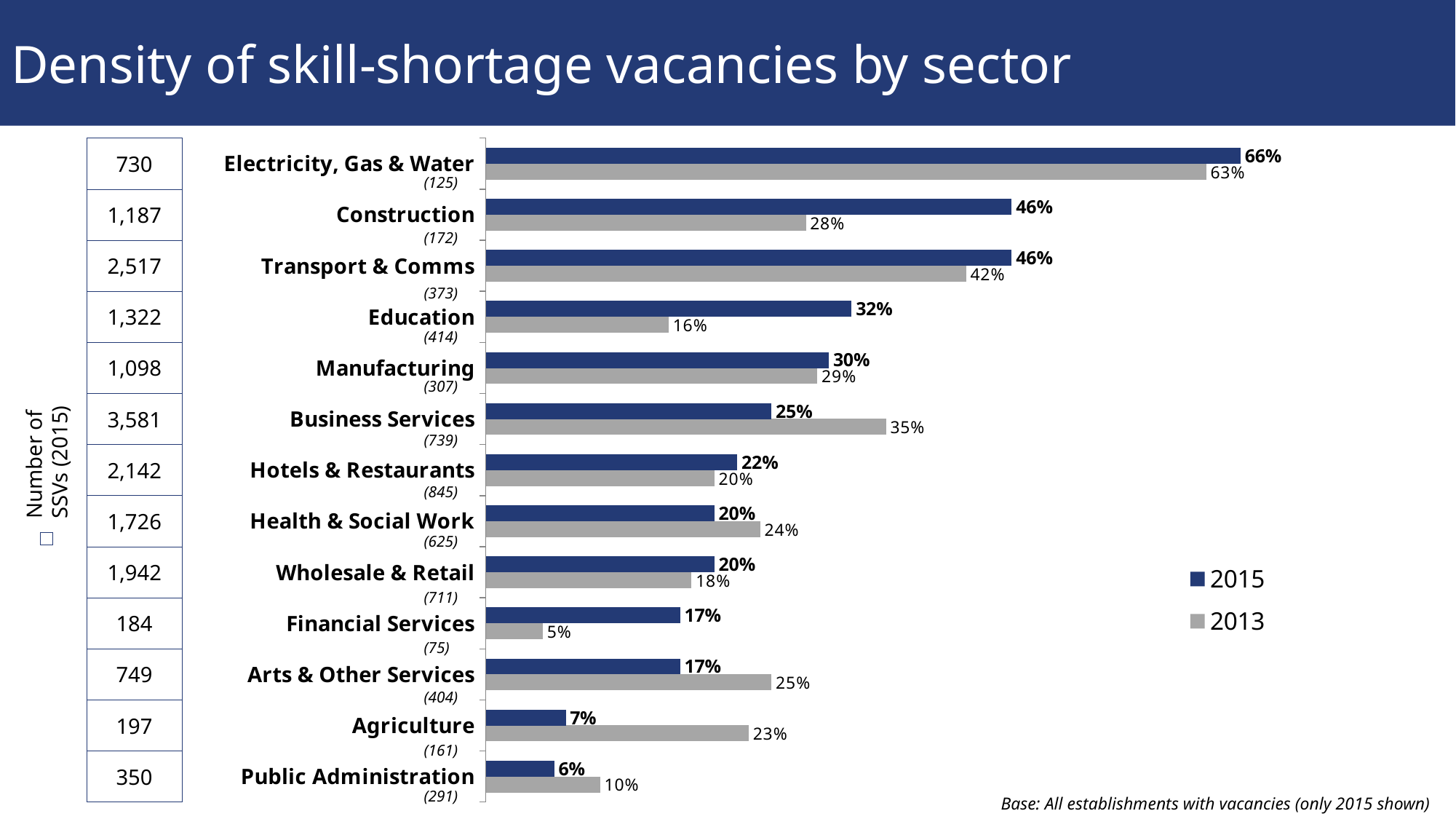
What kind of chart is shown on the slide? Bar chart Which sector has the highest 2015 value? Electricity, Gas & Water What is the difference between the 2015 and 2013 values for Agriculture? 16% What is the 2013 value for Business Services? 35% How many sectors are shown in the chart? 13 Which sector has the lowest 2013 value? Financial Services Which sector has the lowest 2015 value? Public Administration What is the difference between the 2015 and 2013 values for Construction? 18% Which is larger for Health & Social Work, the 2015 value or the 2013 value? 2013 What is the 2013 value for Education? 16% How many series does the legend list? 2 What is the 2015 value for Construction? 46%